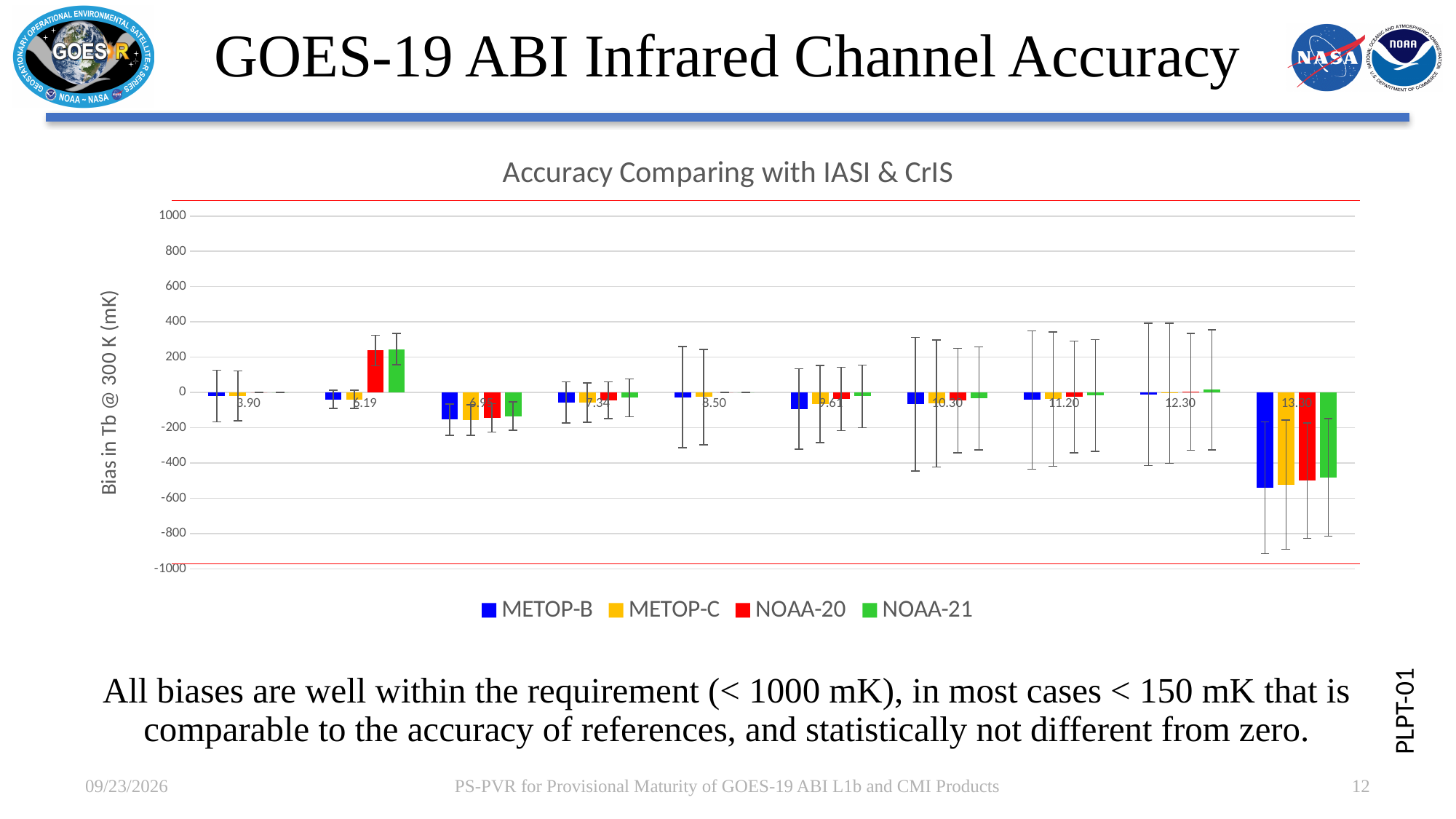
Is the NOAA-21 bias for the rightmost channel group greater or less than -200? less Is the NOAA-21 bias for channel 6.19 greater or less than 100? greater What is the y-axis title of the chart? Bias in Tb @ 300 K (mK) How many series does the legend of the chart list? 4 What kind of chart is shown under the title "Accuracy Comparing with IASI & CrIS"? bar chart Is the METOP-B bias for the rightmost channel group greater or less than -400? less Which channel group has the most negative biases across all four series? the rightmost group (13.30) Which series are listed in the chart legend? METOP-B, METOP-C, NOAA-20, NOAA-21 For channel 6.19, which has the larger bias: NOAA-20 or METOP-B? NOAA-20 How many channel categories (groups of bars) are plotted along the x axis? 10